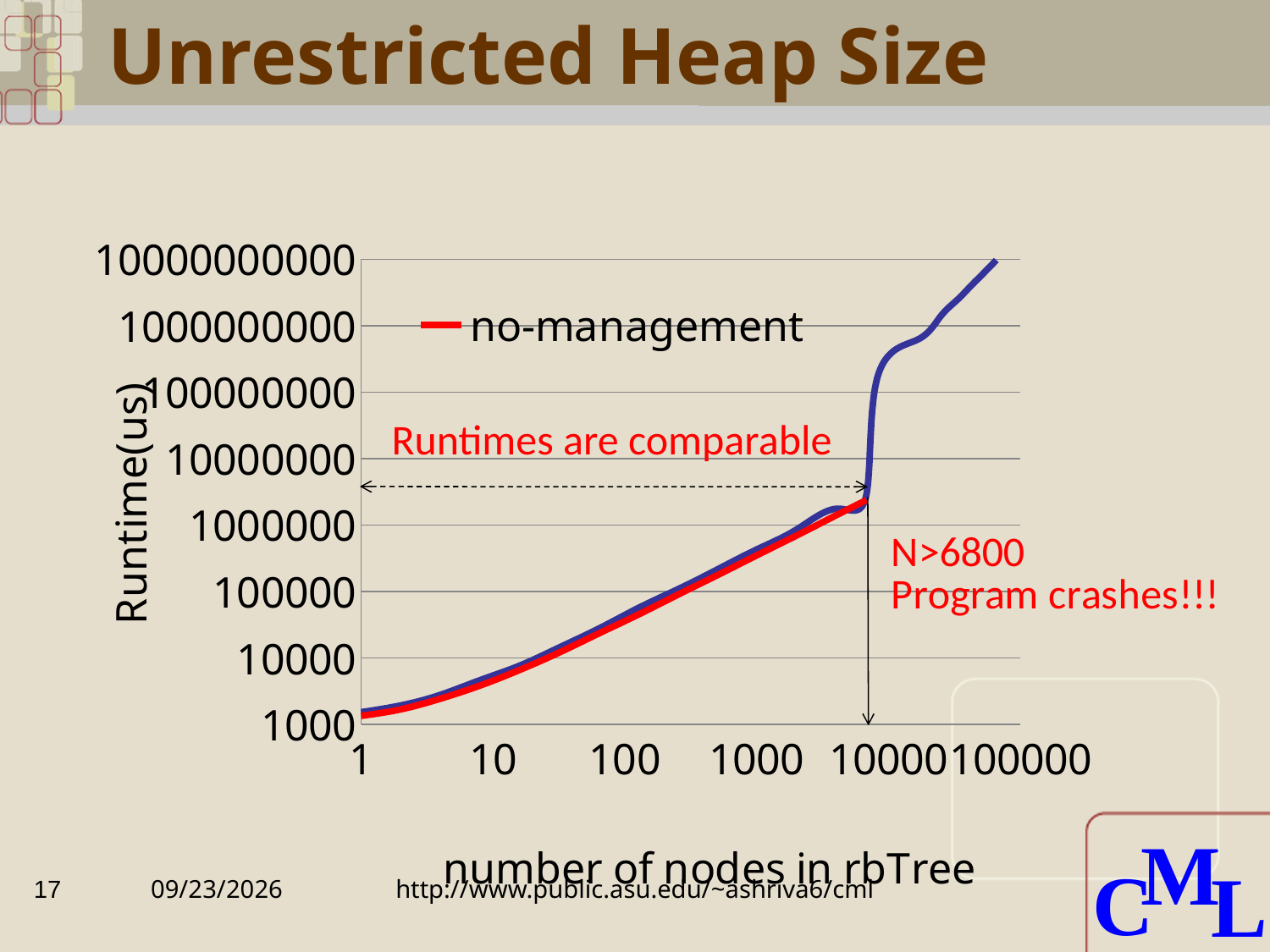
How many series does the legend list? 1 How many tick labels are shown on the x axis? 6 What kind of chart is shown on the slide? line chart Is the runtime for the no-management series at 1000 nodes greater or less than 10000? greater Is the runtime for the no-management series at 1000 nodes greater or less than 1000000? less Does the runtime rise or fall as the number of nodes in rbTree increases? rise What is the highest value labelled on the y axis? 10000000000 Is the runtime for the no-management series at 1 node greater or less than 10000? less What is the label of the x axis? number of nodes in rbTree What is the label of the y axis? Runtime(us)